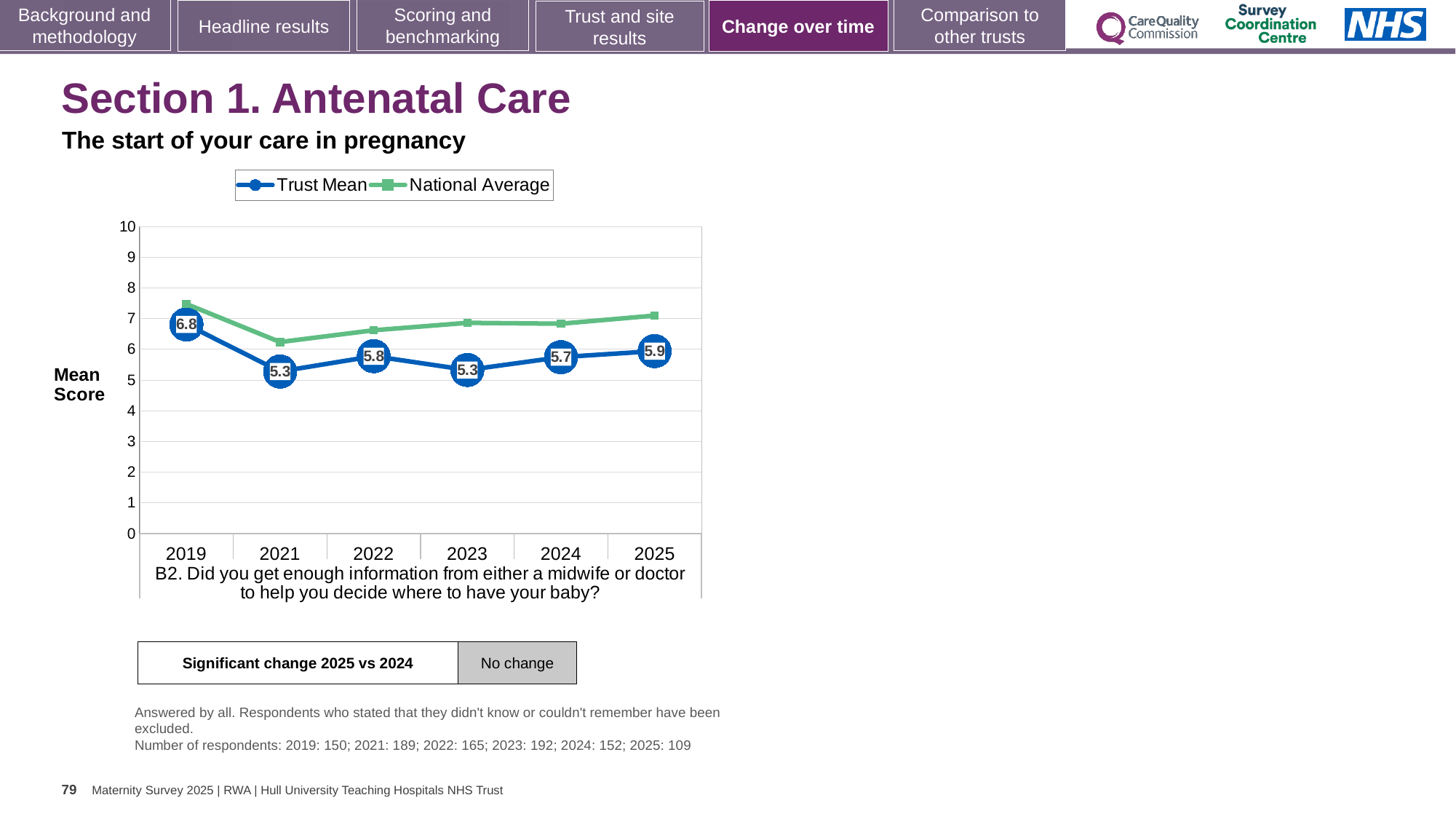
Is the National Average value for 2019 greater or less than 7? greater What is the difference between the Trust Mean score in 2019 and in 2025? 0.9 In which year is the Trust Mean score highest? 2019 What is the Trust Mean score for 2025? 5.9 How many years are plotted on the x axis? 6 What kind of chart is shown on the slide? line chart What is the Trust Mean score for 2019? 6.8 Does the Trust Mean score rise or fall from 2019 to 2021? fall Is the National Average value for 2021 greater or less than 7? less How many series does the legend list? 2 What is the Trust Mean score for 2022? 5.8 Which is larger, the Trust Mean score for 2022 or for 2024? 2022